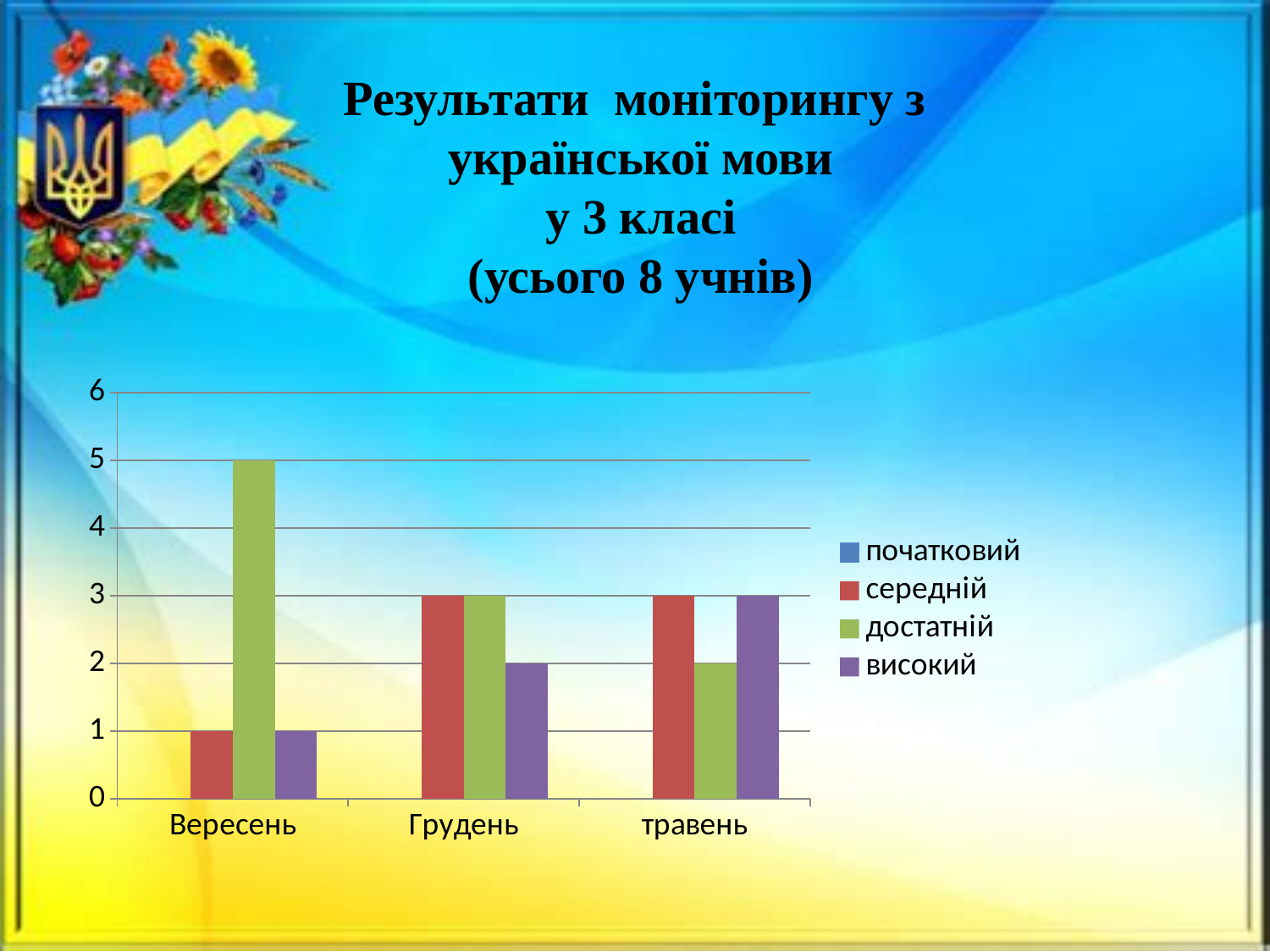
Which legend entry is shown in green? достатній What is the value for середній in травень? 3 What is the value for достатній in Вересень? 5 Which category has the highest value for достатній? Вересень What is the difference between достатній in Вересень and достатній in травень? 3 How many series does the legend list? 4 What is the value for високий in Грудень? 2 Does the value for високий rise or fall from Вересень to травень? rise Which is larger in травень: достатній or високий? високий What kind of chart is shown on the slide? bar chart Which category has the lowest value for високий? Вересень How many categories are shown on the x axis? 3